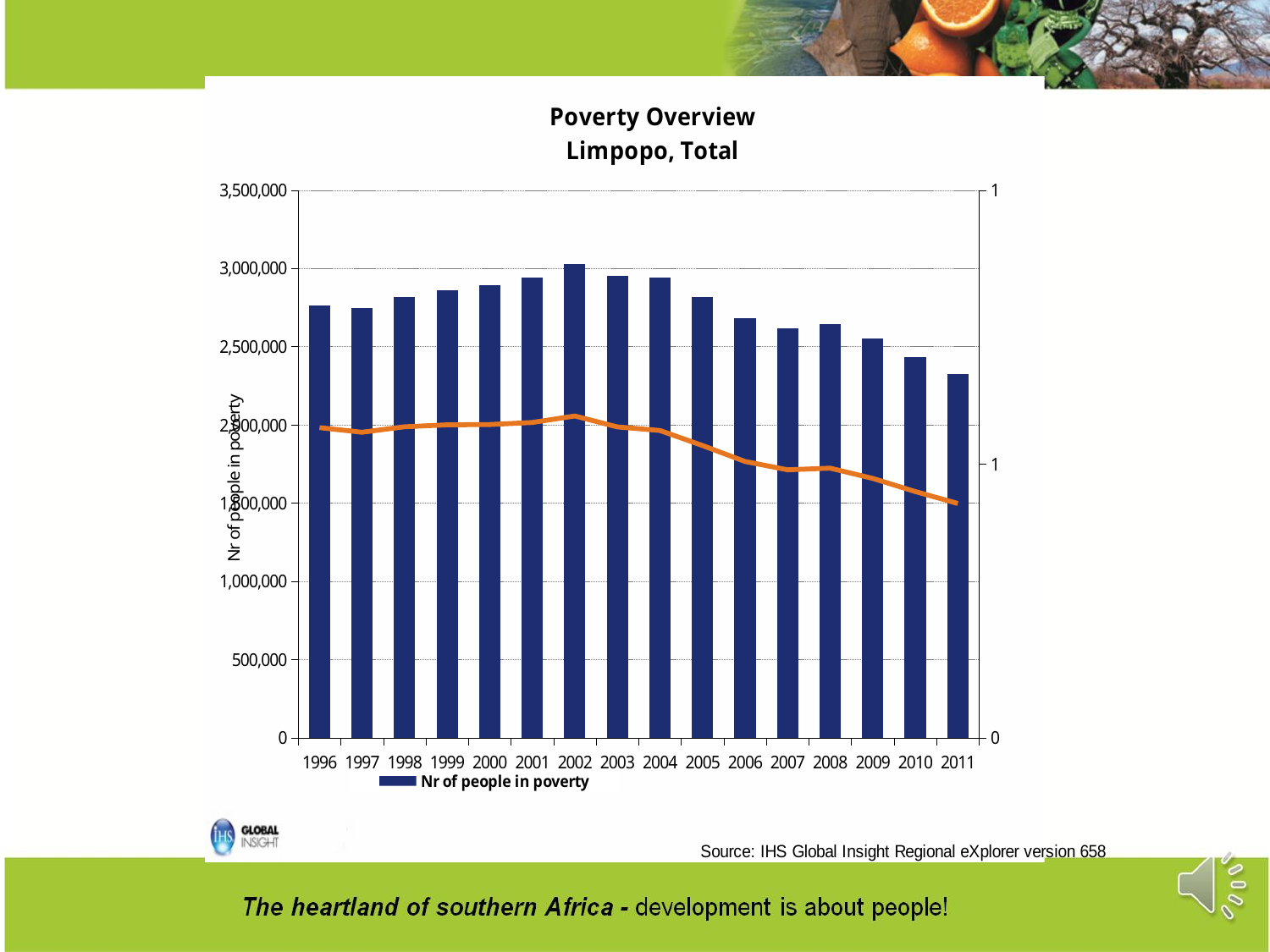
Is the number of people in poverty in 1996 greater or less than 2,500,000? greater Which year has the lowest number of people in poverty? 2011 Which year has more people in poverty, 2002 or 2011? 2002 Do the bars rise or fall from 2002 to 2011? Fall Which year has the highest number of people in poverty? 2002 What is the title of the chart? Poverty Overview Limpopo, Total How many years are shown on the x axis of the chart? 16 Is the number of people in poverty in 2011 greater or less than 2,500,000? less Is the number of people in poverty in 2010 greater or less than 2,500,000? less Which year has more people in poverty, 2003 or 2006? 2003 What kind of chart is used to show the number of people in poverty on this slide? Bar chart